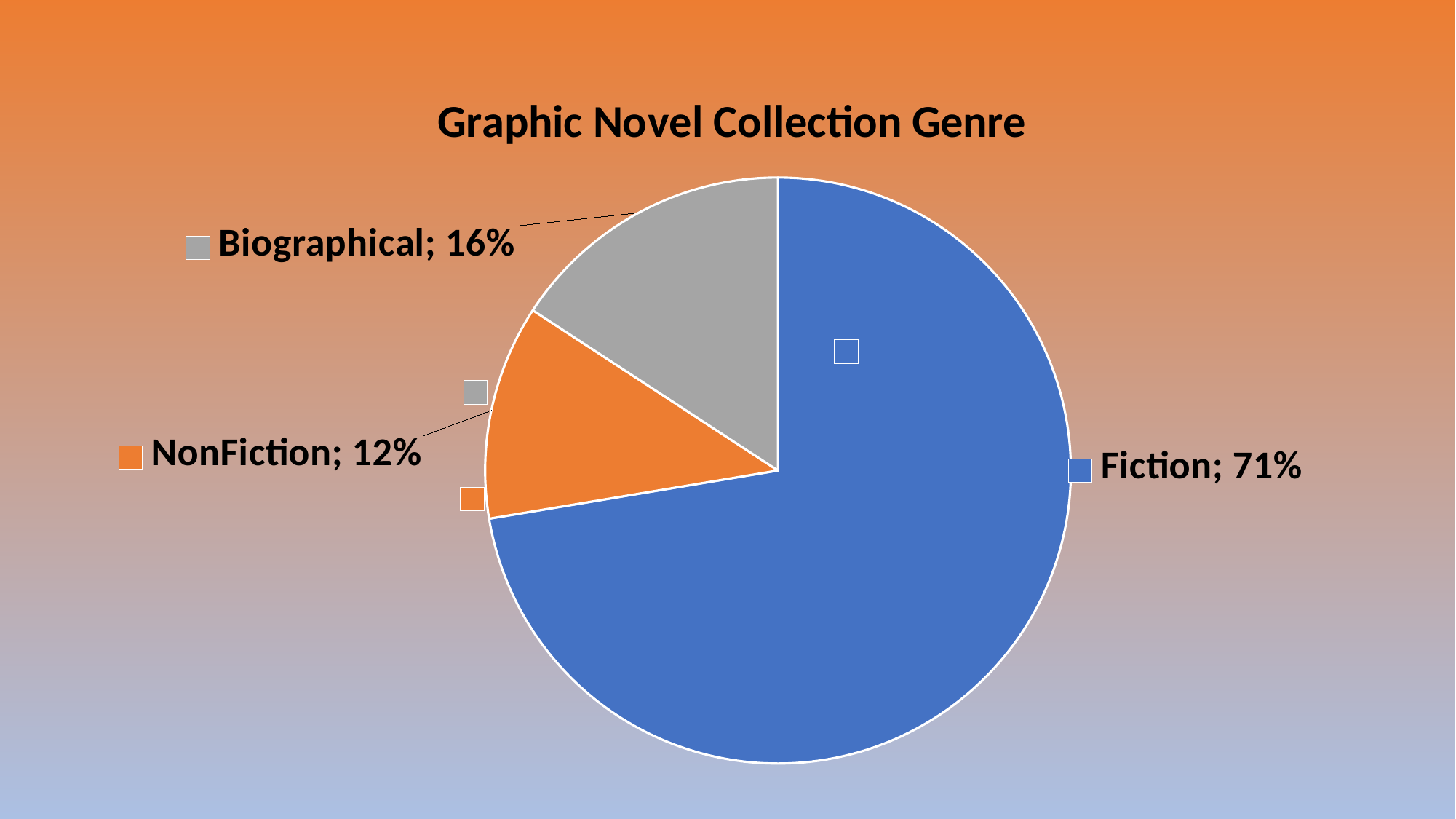
What is the title of the chart? Graphic Novel Collection Genre What kind of chart is shown on the slide? pie chart What is the difference between the Biographical and NonFiction shares? 4% How many slices does the pie chart have? 3 Which genre has the largest slice of the pie? Fiction What colour is the Fiction slice? blue What is the difference between the Fiction and Biographical shares? 55% What is the value shown for Biographical? 16% Which genre has the smallest slice of the pie? NonFiction What share of the pie does Fiction take? 71% What is the value shown for NonFiction? 12% Which is larger, the Biographical slice or the NonFiction slice? Biographical